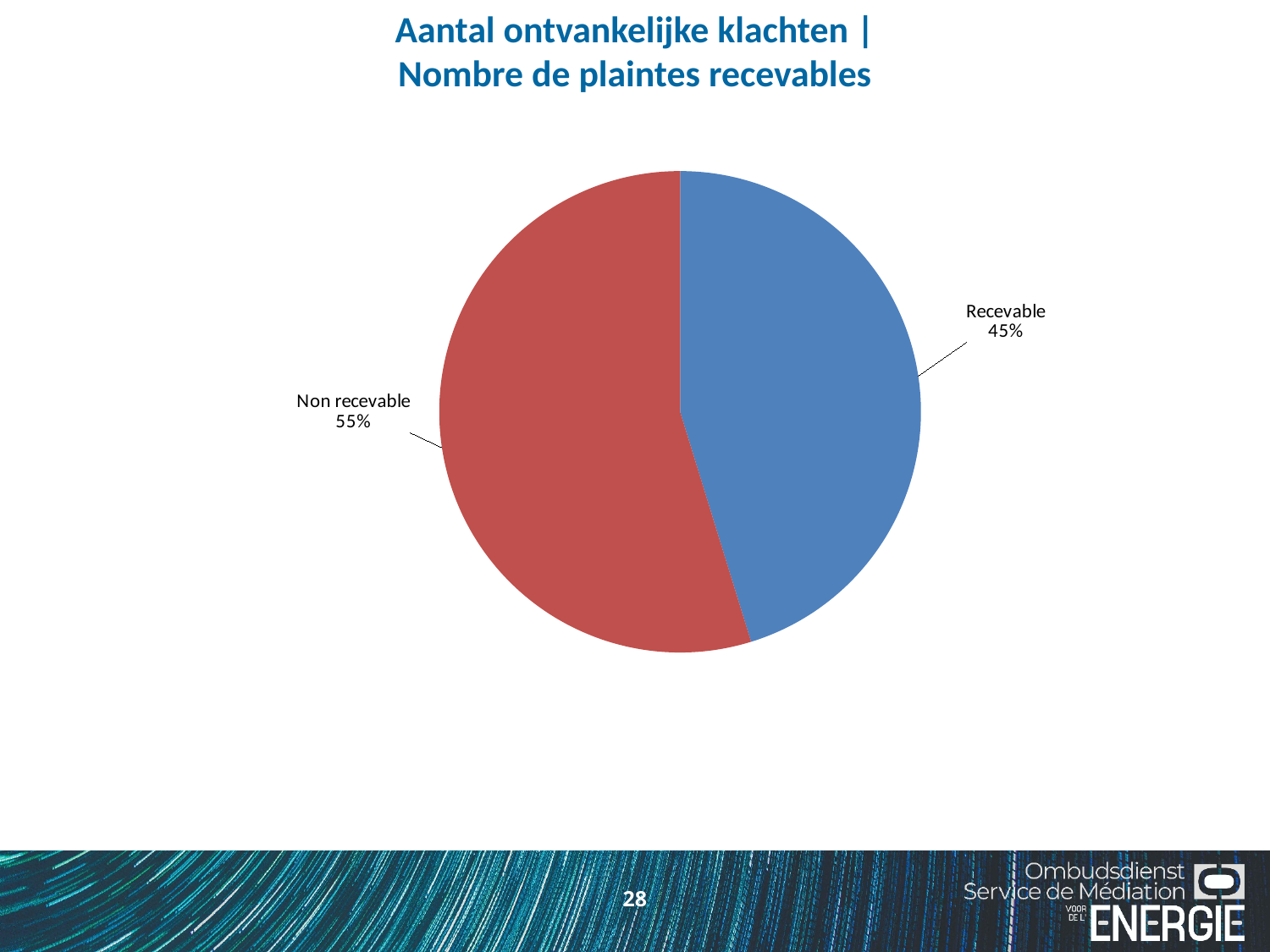
Which is larger, the Recevable slice or the Non recevable slice? Non recevable What is the title of the chart? Aantal ontvankelijke klachten | Nombre de plaintes recevables What is the difference in percentage points between the Non recevable and Recevable slices? 10 percentage points What share of the pie does the Recevable slice represent? 45% Which slice is the largest in the pie chart? Non recevable What share of the pie does the Non recevable slice represent? 55% Is the share for Recevable greater or less than 50%? less Which slice is the smallest in the pie chart? Recevable How many slices does the pie chart have? 2 What colour is the Non recevable slice? Red What kind of chart is shown on the slide? Pie chart